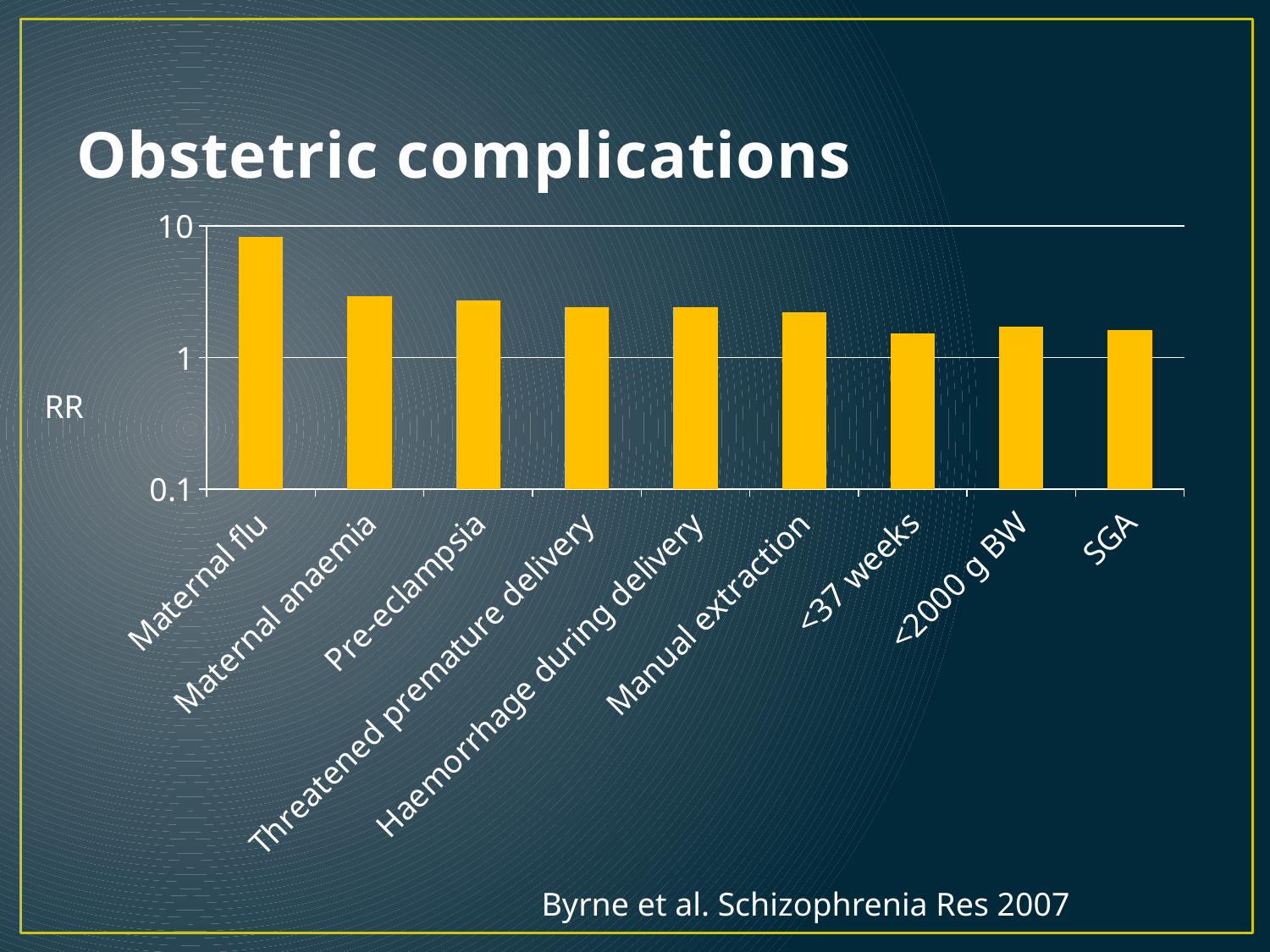
How many obstetric complications (categories) are plotted on the chart? 9 Which has the larger RR value, Maternal flu or Maternal anaemia? Maternal flu Is the RR value for <37 weeks greater or less than 10? less Which has the larger RR value, Maternal anaemia or <37 weeks? Maternal anaemia Which obstetric complication has the highest relative risk (RR) on the chart? Maternal flu Do the RR values generally rise or fall moving from left to right across the categories? fall What is the title of the chart on the slide? Obstetric complications Is the RR value for SGA greater or less than 1? greater What kind of chart is shown on the slide? bar chart What label is shown on the vertical axis of the chart? RR Is the RR value for Maternal flu greater or less than 1? greater